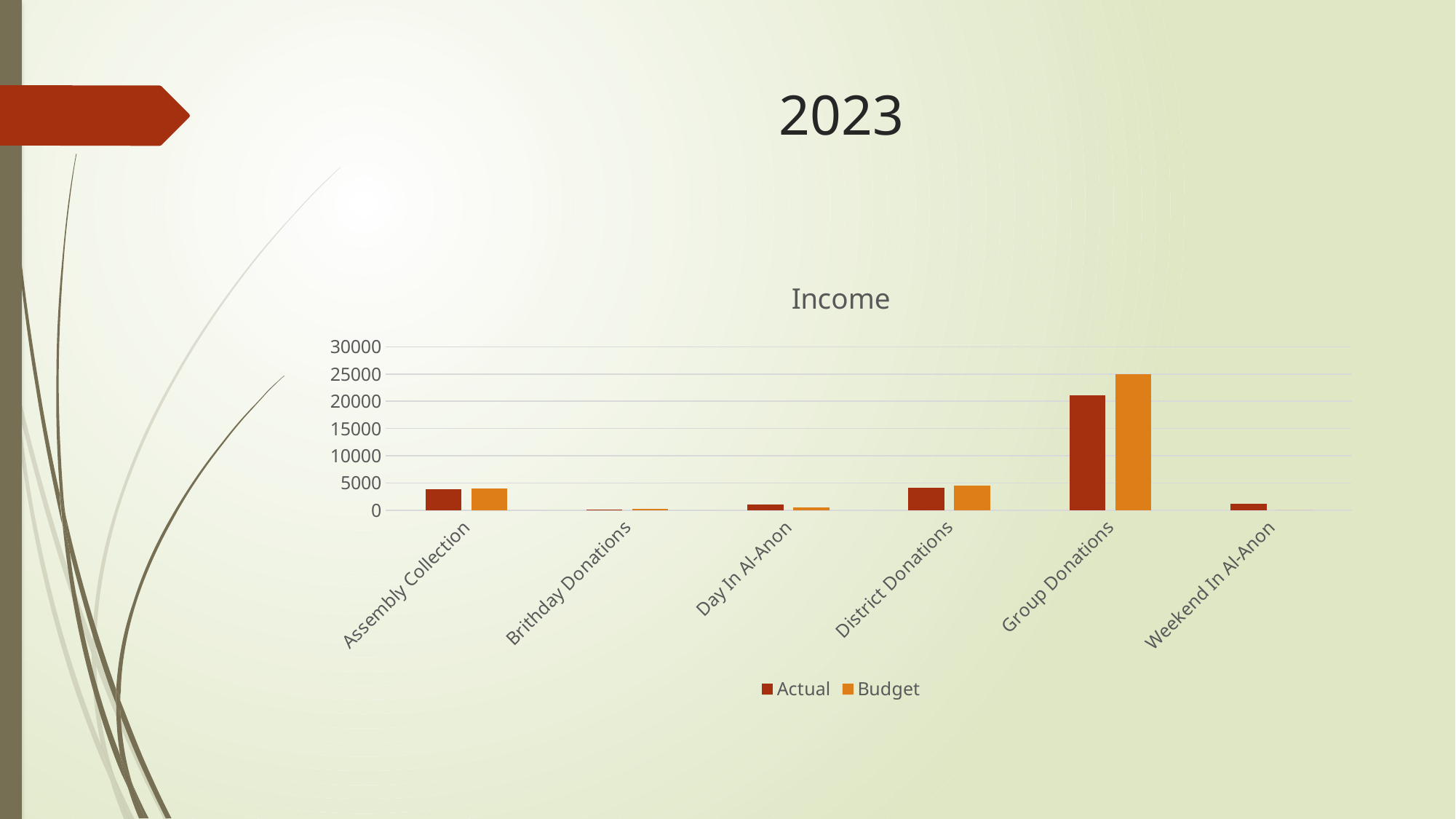
Which category has the lowest Actual value? Brithday Donations How many categories are shown on the x axis? 6 Which series is shown in orange in the legend? Budget Which category has the highest Budget value? Group Donations Is the Actual value for Group Donations greater or less than 20000? greater For Group Donations, which is larger, the Actual or the Budget value? Budget Which category has the highest Actual value? Group Donations What kind of chart is shown on the slide? bar chart For Day In Al-Anon, which is larger, the Actual or the Budget value? Actual What is the title of the chart? Income Is the Actual value for Assembly Collection greater or less than 5000? less How many series does the legend list? 2